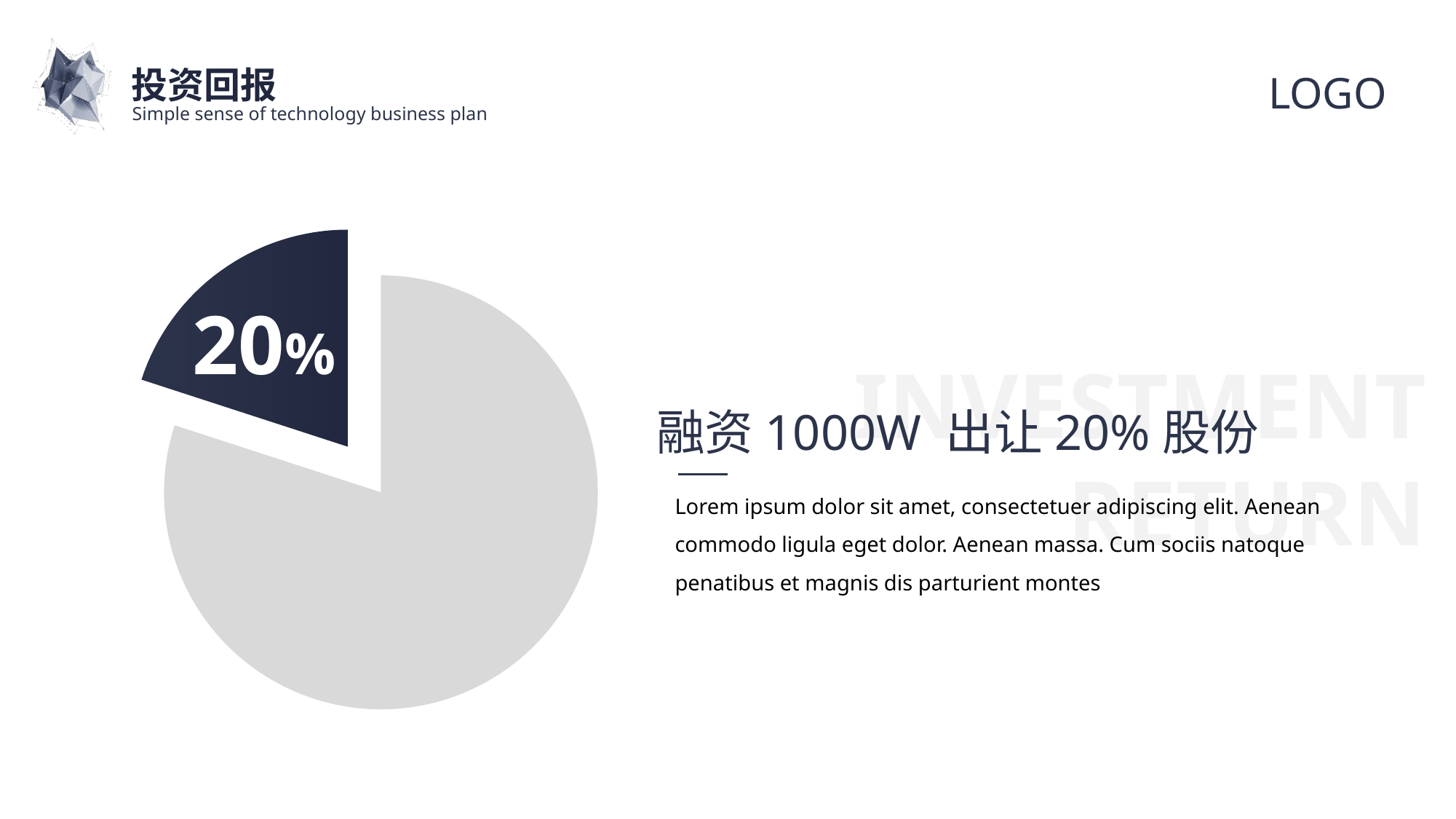
What value is printed on the exploded slice of the pie chart? 20% Which slice of the pie chart is pulled out from the rest of the pie? the 20% slice Which slice of the pie chart is the smallest? the dark blue 20% slice Which slice of the pie chart is larger, the dark blue slice or the grey slice? the grey slice How many slices does the pie chart have? 2 What colour is the slice labelled 20%? dark blue What kind of chart is shown on the slide? pie chart What share of the pie does the dark blue slice represent? 20%